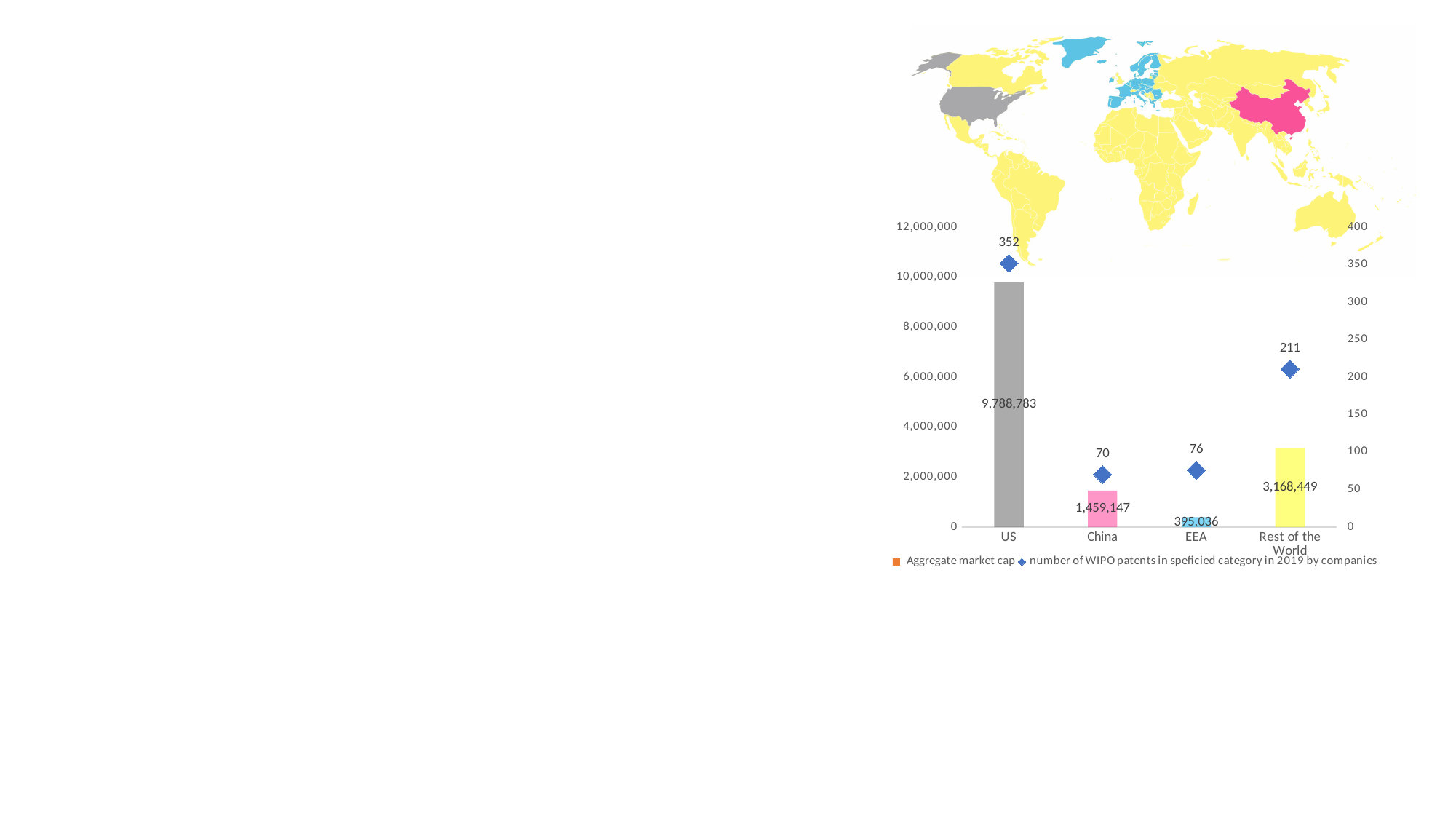
How many WIPO patents in the specified category in 2019 are shown for Rest of the World? 211 How many series does the chart legend list? 2 Which category has the highest number of WIPO patents in the specified category in 2019? US What is the Aggregate market cap value for China? 1,459,147 Which has a larger Aggregate market cap, China or Rest of the World? Rest of the World What is the Aggregate market cap value for Rest of the World? 3,168,449 What is the Aggregate market cap value for the EEA? 395,036 What is the difference in number of WIPO patents between the EEA and China? 6 Which category has the lowest Aggregate market cap? EEA What is the Aggregate market cap value for the US? 9,788,783 How many categories are shown on the x axis of the chart? 4 How many WIPO patents in the specified category in 2019 are shown for the US? 352